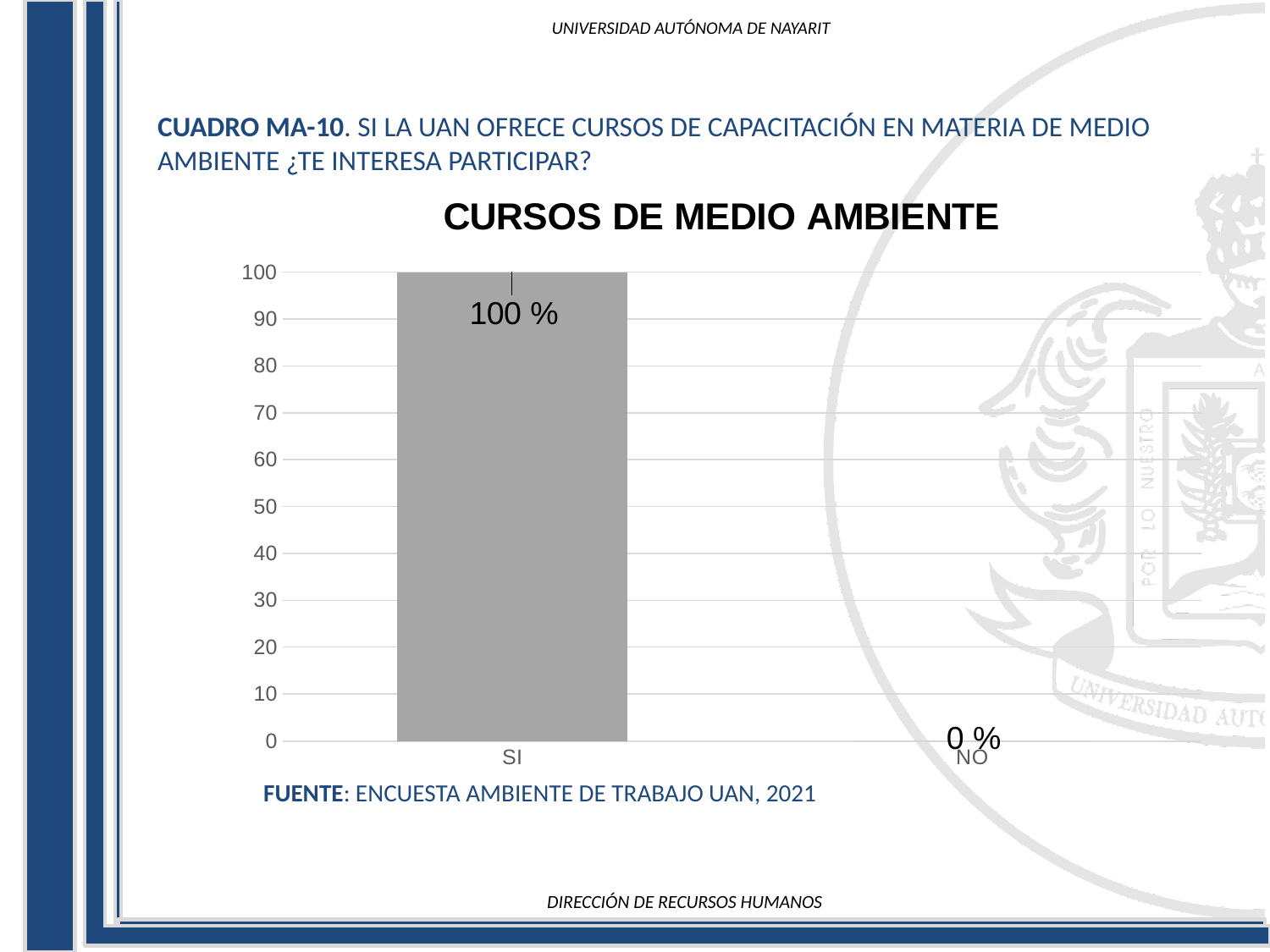
What kind of chart is shown? bar chart Which is larger, the value for SI or the value for NO? SI Do the values rise or fall from SI to NO? fall What is the title of the chart? CURSOS DE MEDIO AMBIENTE Which category has the highest value? SI What is the value for SI? 100 % How many categories are shown on the x axis? 2 What is the maximum value shown on the y axis? 100 What is the value for NO? 0 % What is the difference between the values for SI and NO? 100 % Is the value for SI greater or less than 50? greater Which category has the lowest value? NO